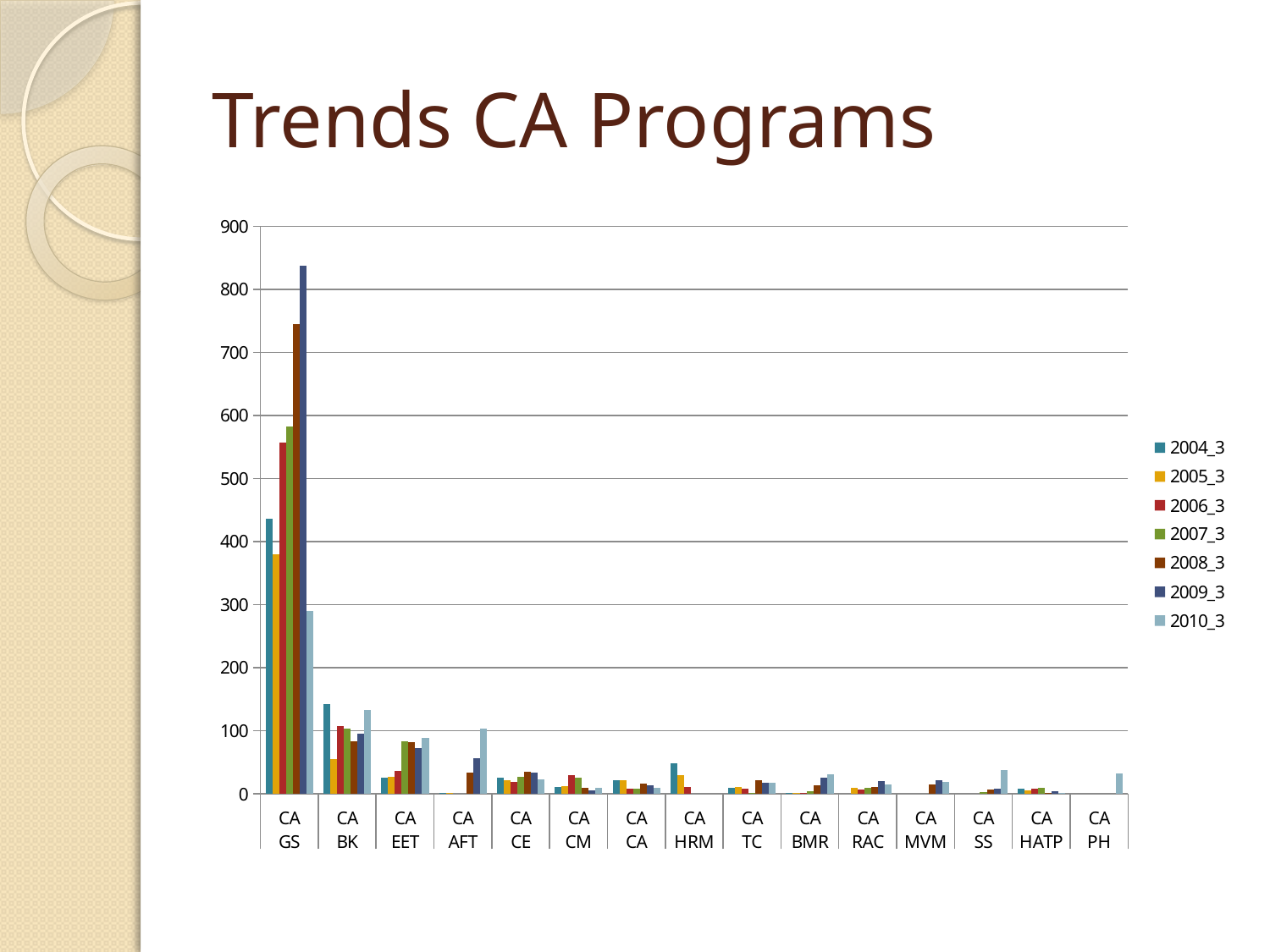
Is the 2007_3 value for CA EET greater or less than 100? less Is the 2004_3 value for CA GS greater or less than 400? greater Which program category has the tallest bars in the chart? CA GS What is the title of the slide? Trends CA Programs How many series does the legend list? 7 Is the 2010_3 value for CA BK greater or less than 100? greater Within the CA GS category, which series has the lowest bar? 2010_3 For CA GS, which is larger: the 2008_3 value or the 2009_3 value? 2009_3 What kind of chart is shown on the slide? bar chart Within the CA GS category, which series has the highest bar? 2009_3 How many program categories are shown along the x axis? 15